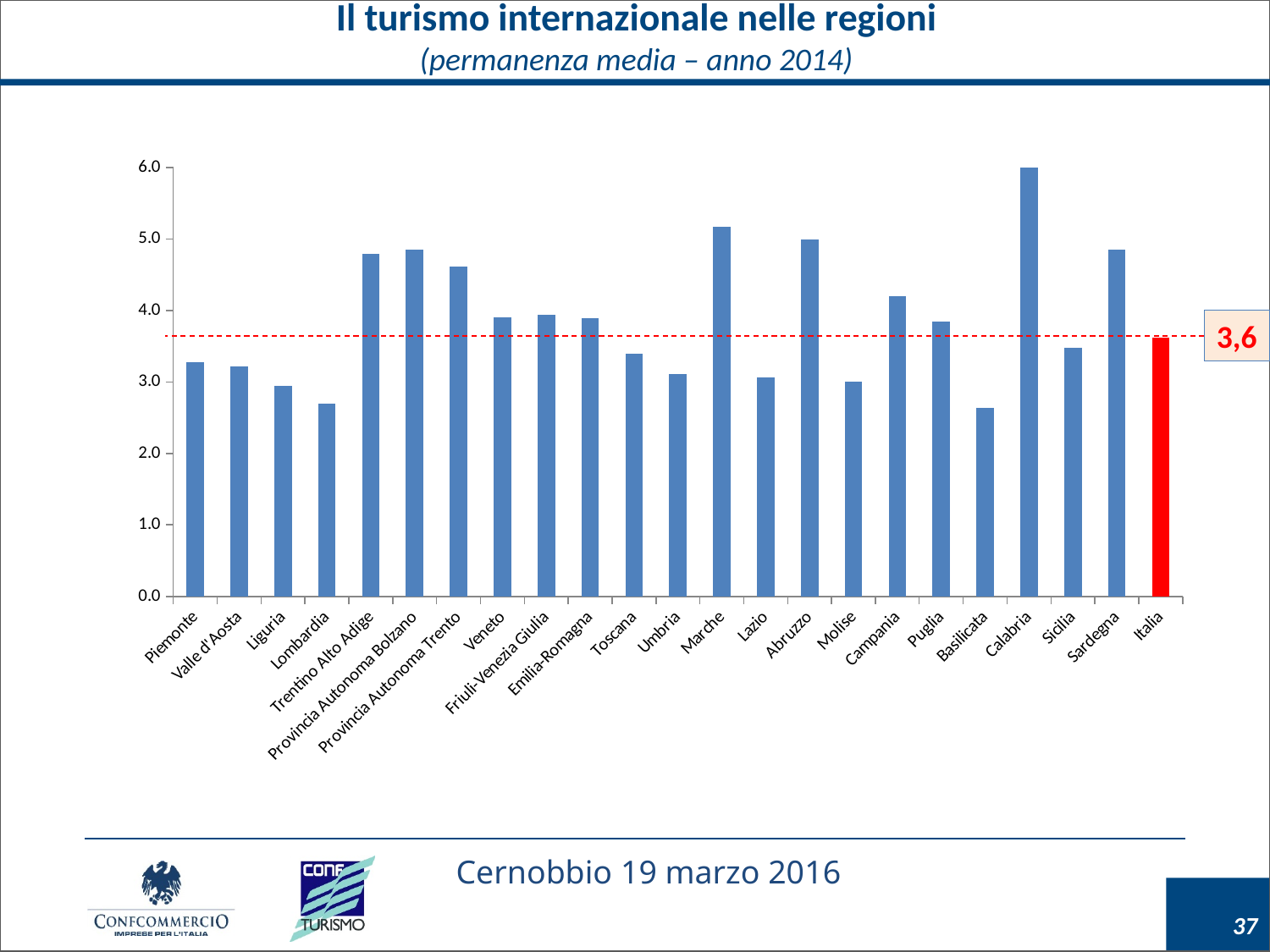
How many categories are plotted along the x axis? 23 Which is larger, the value for Marche or the value for Lazio? Marche Which category has the lowest value? Basilicata Is the value for Marche greater or less than 5.0? greater Is the value for Lombardia greater or less than 3.0? less What colour is the bar for Italia? red Is the value for Sardegna greater or less than 4.0? greater Which category has the highest value? Calabria What value is labelled for Italia? 3,6 What kind of chart is shown on the slide? bar chart Which is larger, the value for Trentino Alto Adige or the value for Veneto? Trentino Alto Adige